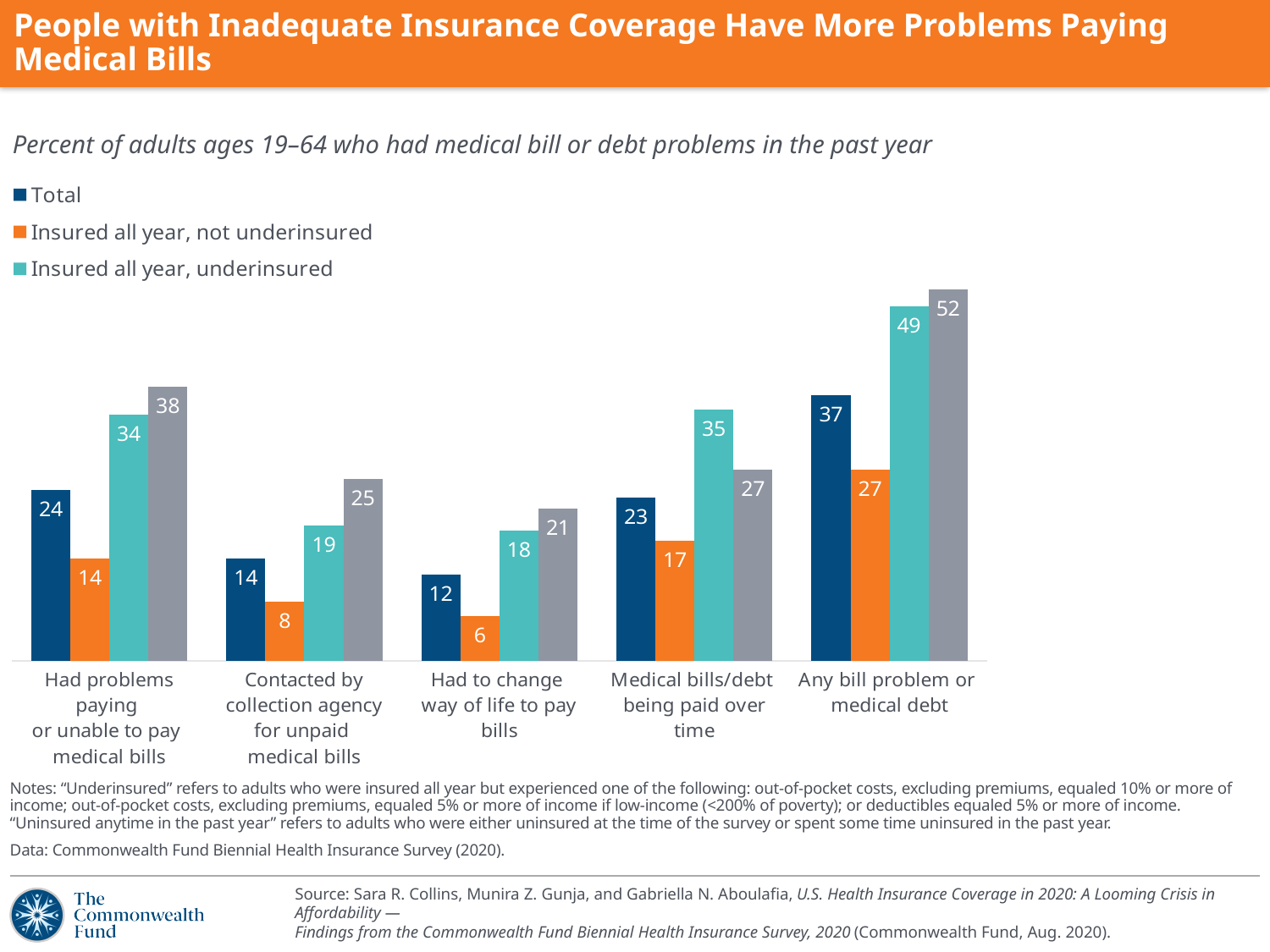
For "Had to change way of life to pay bills", which is larger: the Total value or the "Insured all year, underinsured" value? Insured all year, underinsured What colour represents the Total series in the legend? Dark blue How many categories are shown on the x axis? 5 How many series does the legend list? 3 What is the difference between the Total values for "Any bill problem or medical debt" and "Had problems paying or unable to pay medical bills"? 13 What is the value for "Insured all year, underinsured" in the "Medical bills/debt being paid over time" category? 35 What is the Total value for "Any bill problem or medical debt"? 37 What kind of chart is shown on the slide? Bar chart What is the value for "Insured all year, not underinsured" in the "Contacted by collection agency for unpaid medical bills" category? 8 What is the difference between the "Insured all year, underinsured" and "Insured all year, not underinsured" values for "Had problems paying or unable to pay medical bills"? 20 Which category has the highest value for "Insured all year, underinsured"? Any bill problem or medical debt Which category has the lowest Total value? Had to change way of life to pay bills